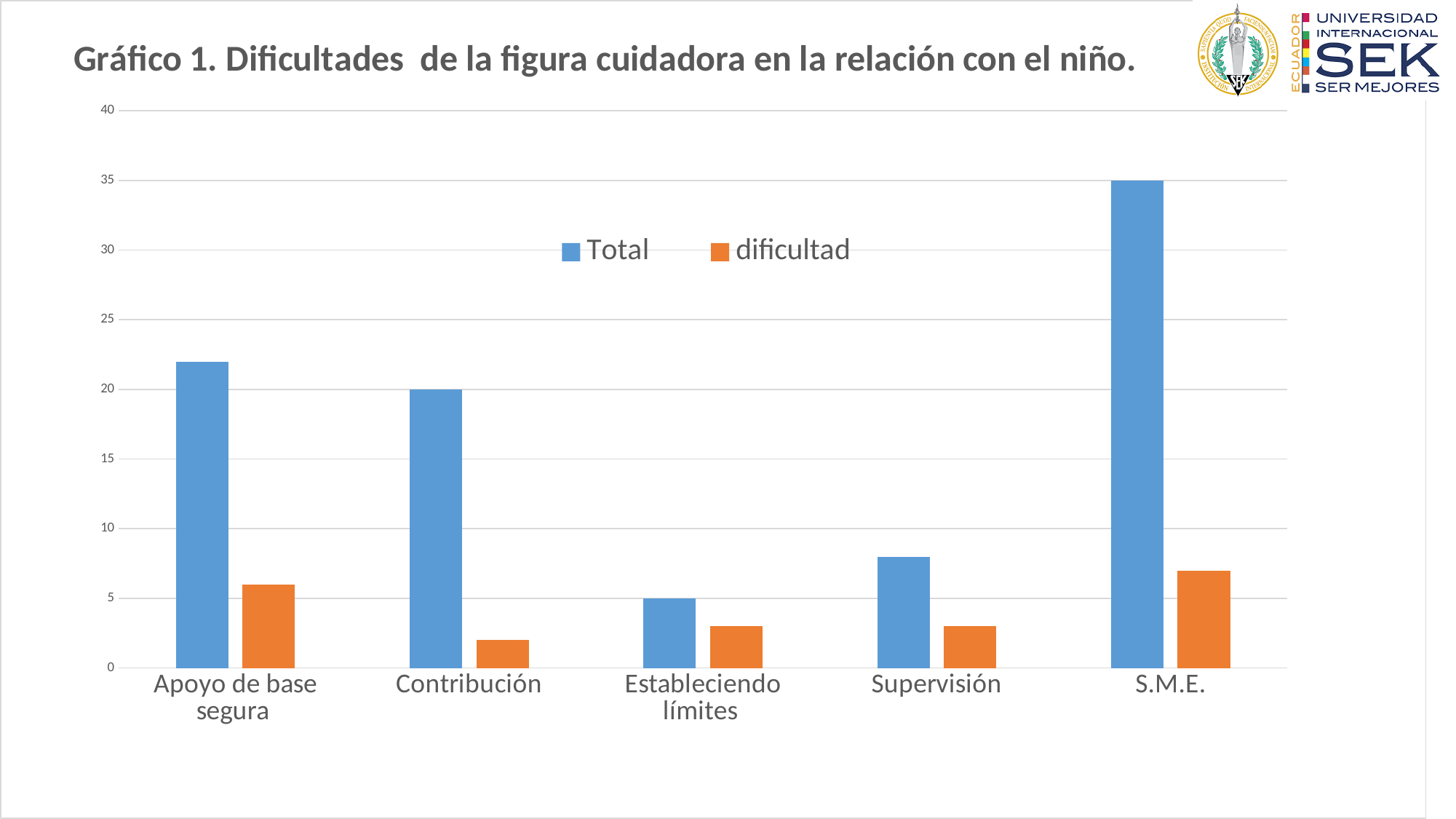
How many series does the legend list? 2 What is the Total value for Estableciendo límites? 5 Is the Total value for Apoyo de base segura greater or less than 20? greater What is the Total value for S.M.E.? 35 How many categories are shown on the x axis? 5 What type of chart is shown on the slide? bar chart Which is larger, the Total value for Supervisión or the Total value for Contribución? Contribución Which category has the lowest Total value? Estableciendo límites Is the dificultad value for Contribución greater or less than 5? less Which category has the highest Total value? S.M.E. What colour are the bars for the dificultad series? orange What is the Total value for Contribución? 20